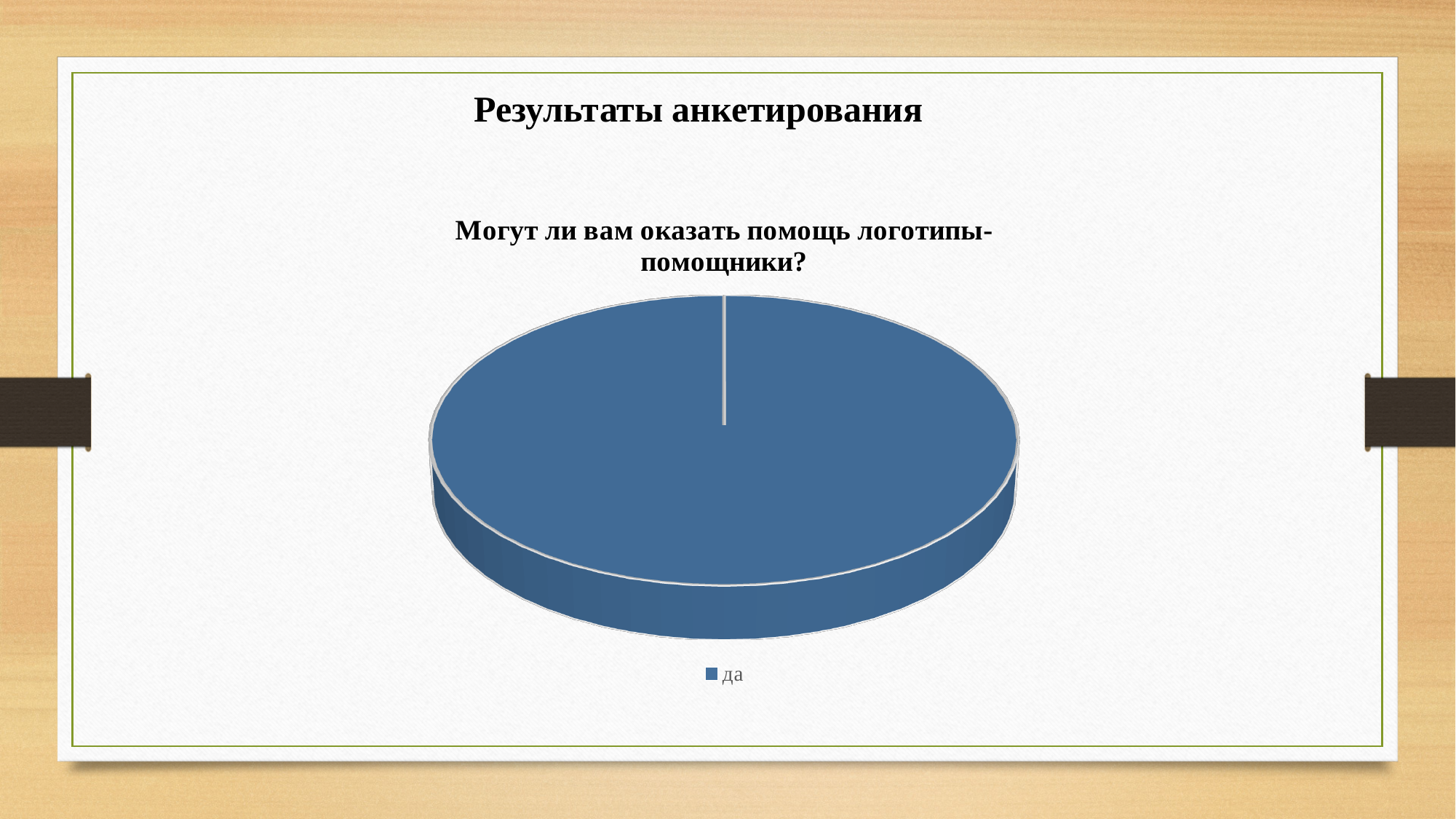
What is the label of the only legend entry in the pie chart? да How many slices does the pie chart have? 1 Which category makes up the largest slice of the pie chart? да How many entries does the legend of the pie chart list? 1 What is the title of the pie chart? Могут ли вам оказать помощь логотипы-помощники? What kind of chart is shown on the slide? pie chart